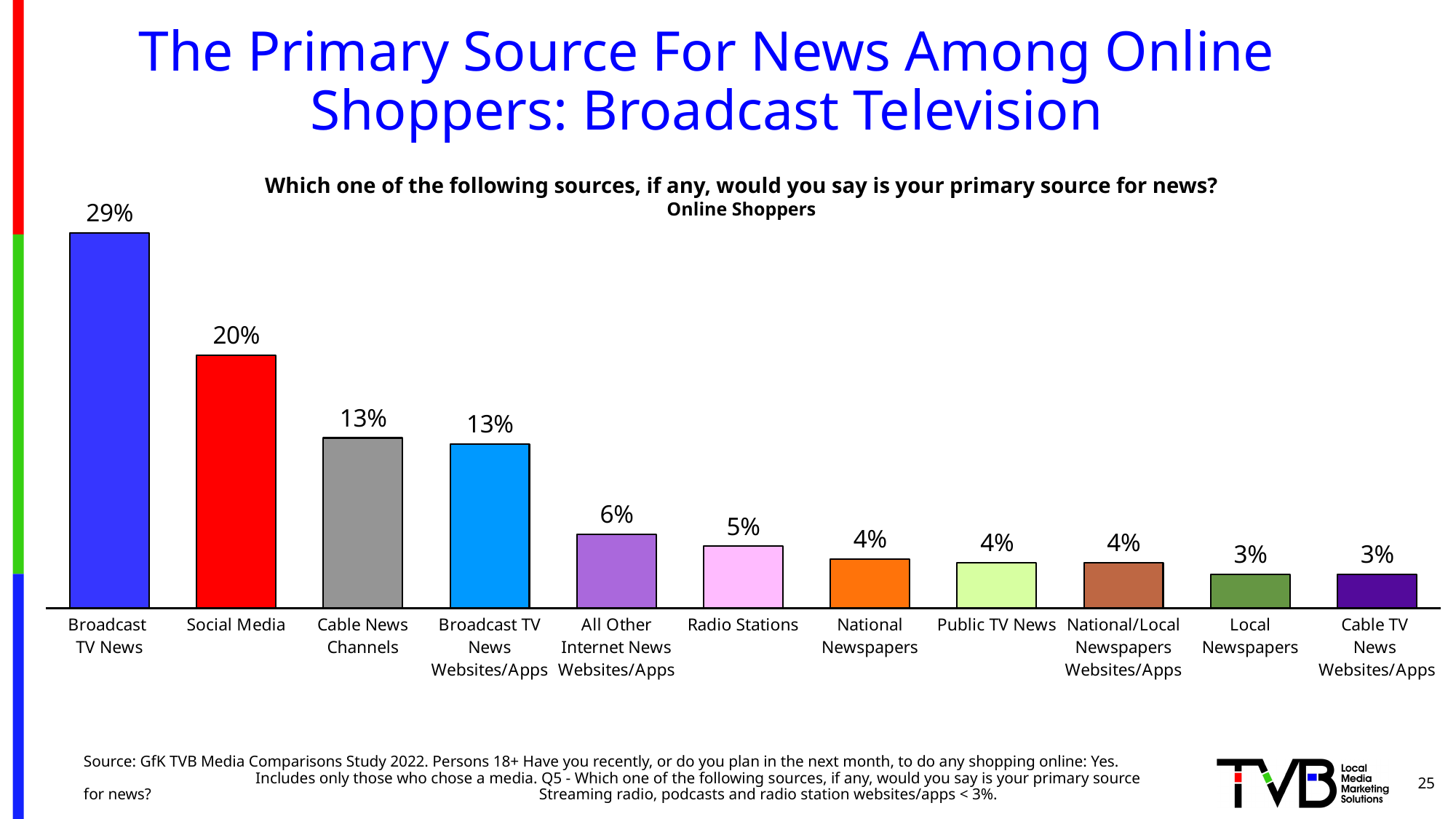
What is the value shown for All Other Internet News Websites/Apps? 6% What is the difference between the values for Social Media and Cable News Channels? 7% Which source has the highest value in the chart? Broadcast TV News How many news sources (bars) are shown in the chart? 11 Do the values generally rise or fall moving from left to right across the chart? Fall What is the value shown for Social Media? 20% What is the value shown for Radio Stations? 5% What is the difference between the values for Broadcast TV News and Social Media? 9% Which is larger, the value for Social Media or the value for Radio Stations? Social Media What percentage of online shoppers say Broadcast TV News is their primary source for news? 29% What is the subtitle shown directly below the chart's question title? Online Shoppers What kind of chart is shown on the slide? Bar chart